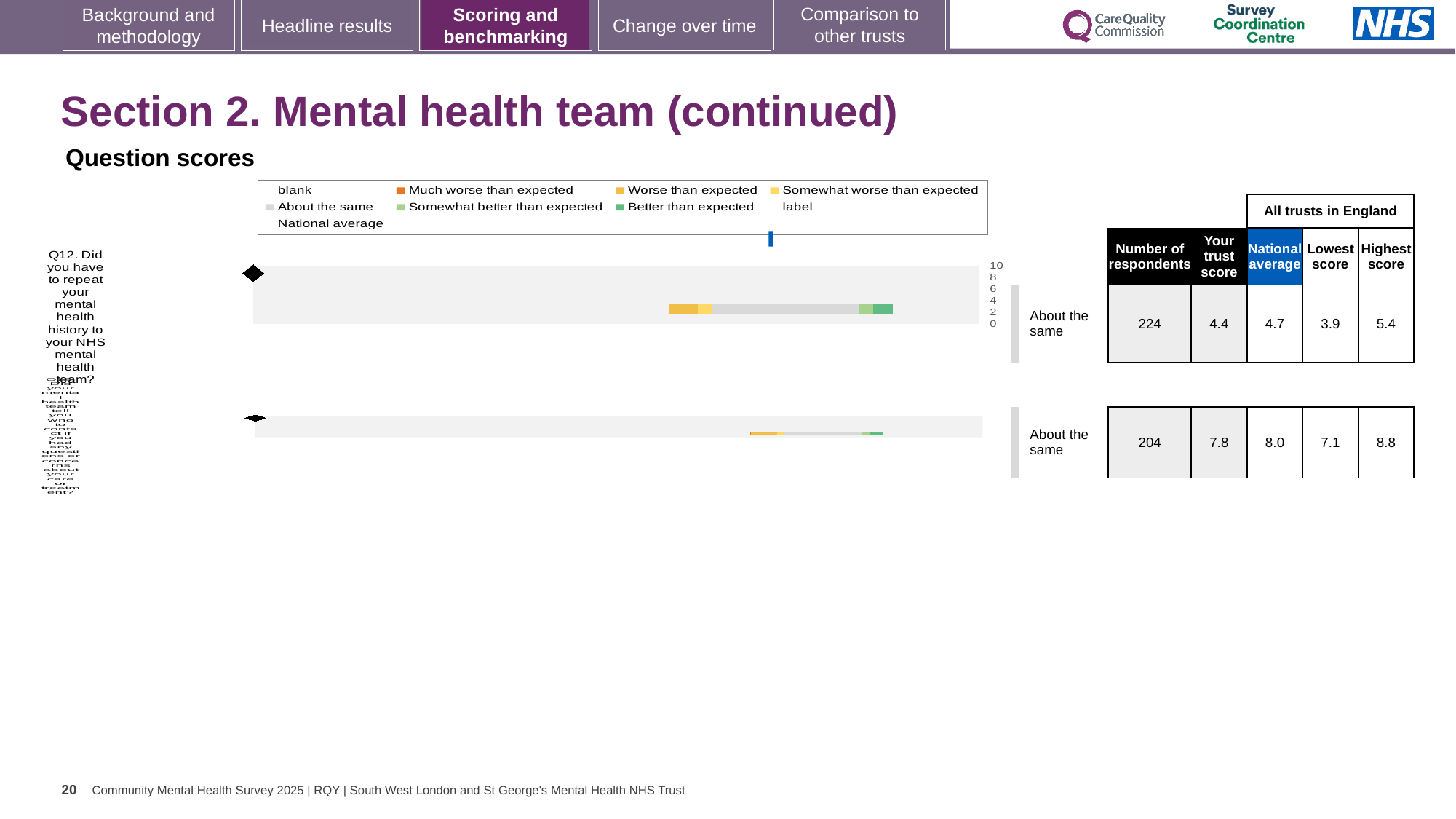
In the table beside the Q12 chart, what is your trust score? 4.4 In the chart legend, which category is shown in grey? About the same In the table beside the lower chart, what is your trust score? 7.8 In the table beside the lower chart, what is the difference between the highest score (8.8) and the lowest score (7.1)? 1.7 In the table beside the Q12 chart, what is the number of respondents? 224 In the chart legend, which category is shown in orange? Much worse than expected How many question charts are shown on the slide? 2 In the table beside the Q12 chart, what is the national average? 4.7 For Q12, which is larger: your trust score or the national average? National average What benchmark category is given for Q12 (repeating mental health history) next to its chart? About the same What kind of chart is used to show the Q12 benchmark result? bar chart For Q12, what is the difference between the highest score (5.4) and the lowest score (3.9) across all trusts in England? 1.5